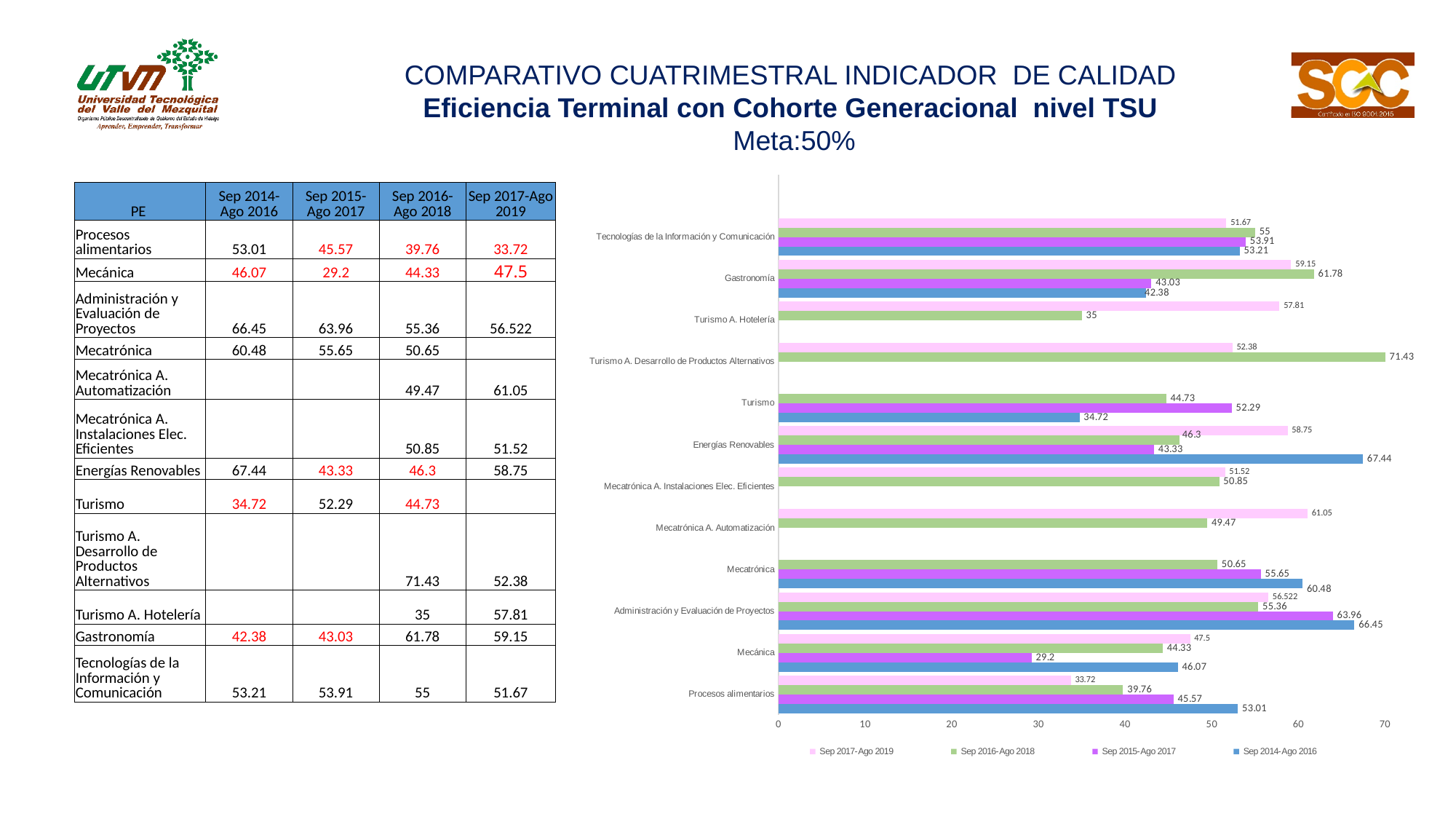
What is the Sep 2017-Ago 2019 value for Administración y Evaluación de Proyectos? 56.522 Do the values for Procesos alimentarios rise or fall from Sep 2014-Ago 2016 to Sep 2017-Ago 2019? Fall What is the difference between the Sep 2016-Ago 2018 and Sep 2014-Ago 2016 values for Gastronomía? 19.4 How many series does the chart legend list? 4 Which program has the highest value of any series in the chart? Turismo A. Desarrollo de Productos Alternativos What is the Sep 2016-Ago 2018 value for Turismo A. Desarrollo de Productos Alternativos? 71.43 What type of chart is shown on the slide? Bar chart Which series is shown in blue in the chart legend? Sep 2014-Ago 2016 How many programs (categories) are plotted in the chart? 12 Which program has the lowest value of any series in the chart? Mecánica What is the Sep 2015-Ago 2017 value for Mecánica? 29.2 For Energías Renovables, which is larger: the Sep 2014-Ago 2016 value or the Sep 2017-Ago 2019 value? Sep 2014-Ago 2016